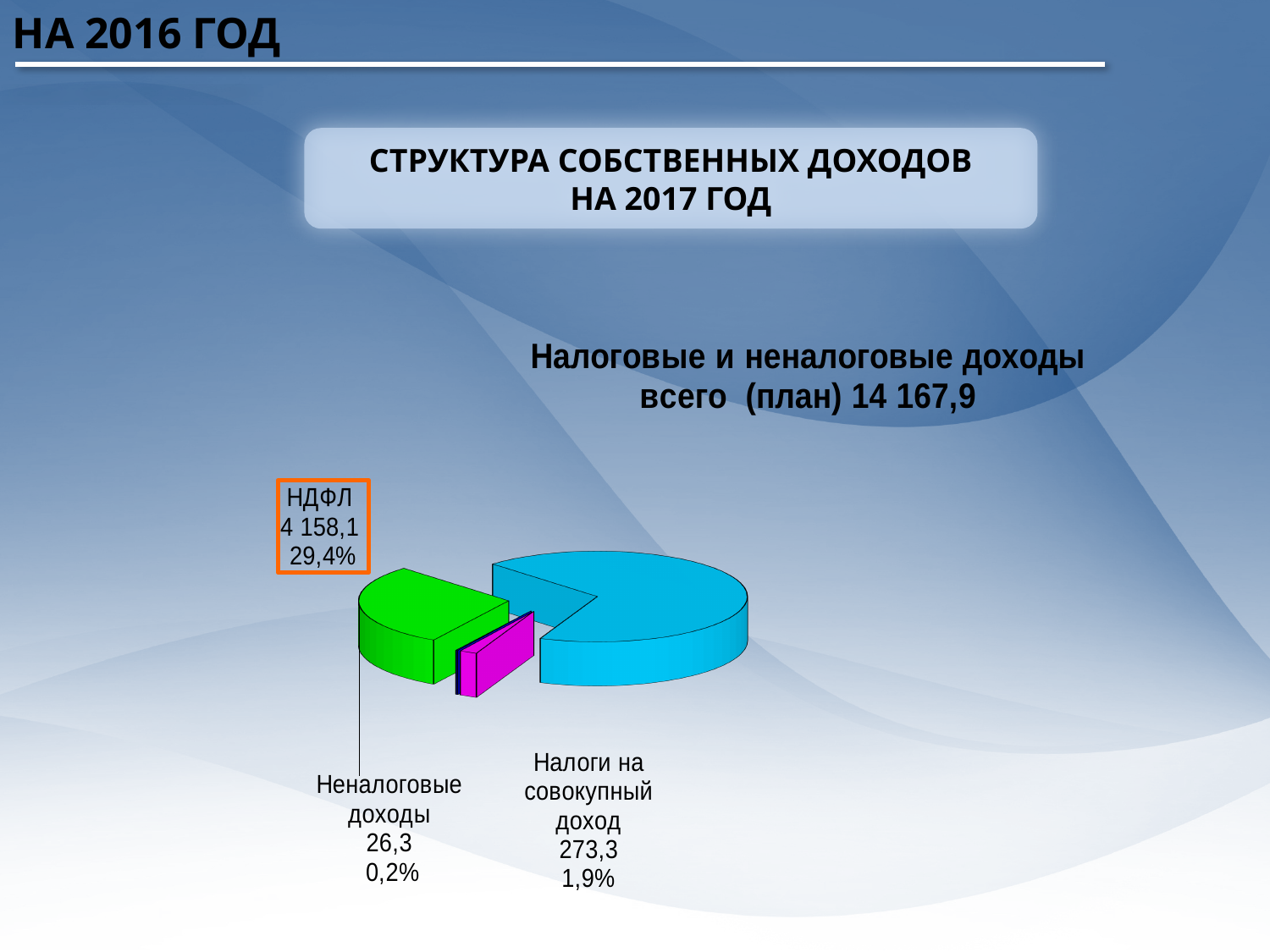
What share of the pie does Налоги на совокупный доход account for? 1,9% What is the value shown for Неналоговые доходы? 26,3 Which of the labelled slices has the largest value? НДФЛ What is the value shown for Налоги на совокупный доход? 273,3 What share of the pie does НДФЛ account for? 29,4% What kind of chart is shown on the slide? pie chart What share of the pie does Неналоговые доходы account for? 0,2% What is the value shown for НДФЛ? 4 158,1 Which of the labelled slices has the smallest value? Неналоговые доходы Which is larger, Налоги на совокупный доход or Неналоговые доходы? Налоги на совокупный доход What total planned value for tax and non-tax revenues is stated above the chart? 14 167,9 What is the difference between the values for НДФЛ and Налоги на совокупный доход? 3 884,8